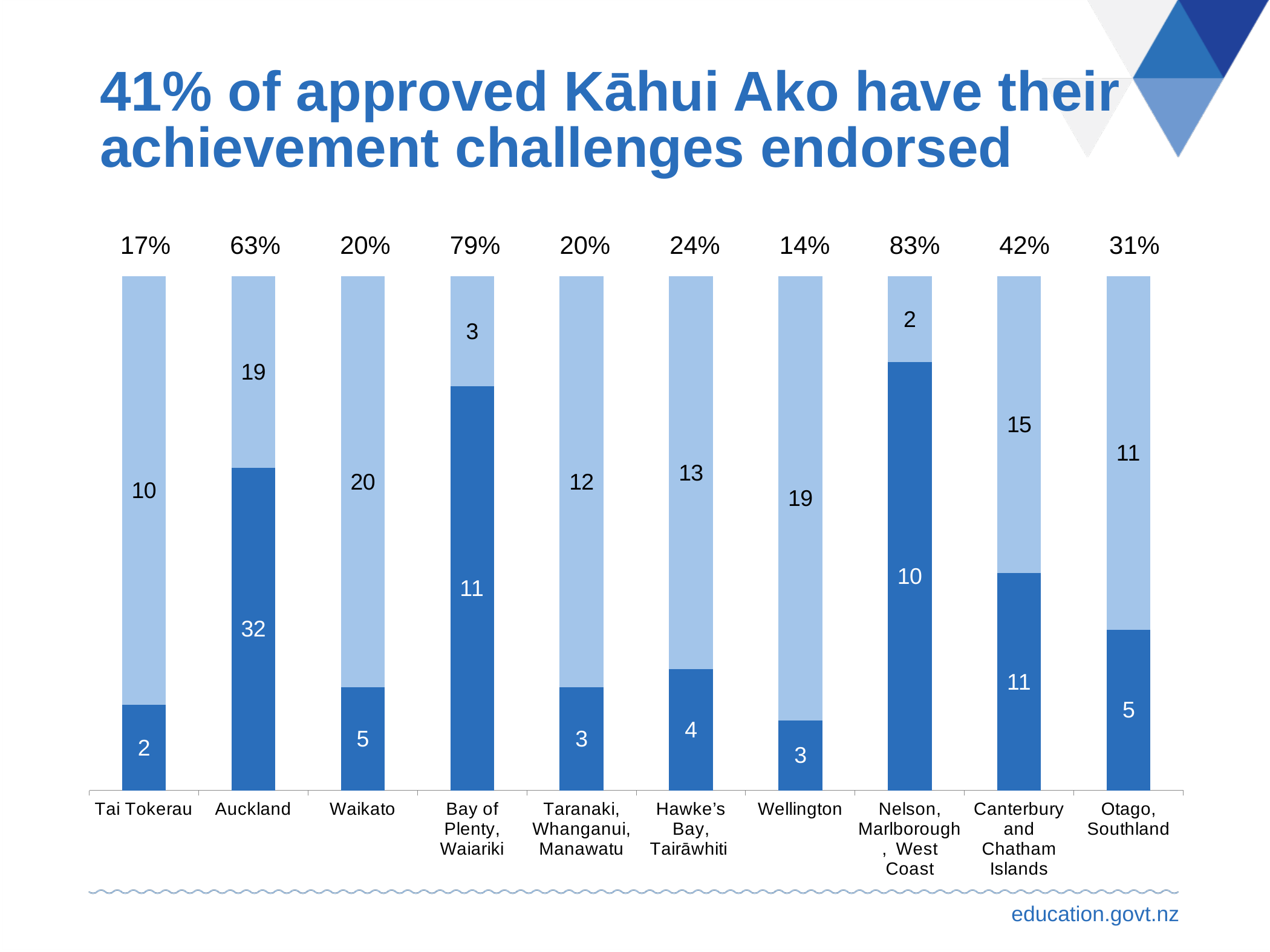
How many regions are shown on the x axis? 10 What is the difference between the dark blue values for Auckland and Canterbury and Chatham Islands? 21 What value is printed in the light blue segment of the Wellington bar? 19 Which has the larger dark blue value, Waikato or Otago, Southland? They are equal (5) What percentage is shown above the Auckland bar? 63% Which region has the lowest percentage shown above its bar? Wellington Which region has the highest percentage shown above its bar? Nelson, Marlborough, West Coast What is the title of the slide? 41% of approved Kāhui Ako have their achievement challenges endorsed What value is printed in the dark blue segment of the Bay of Plenty, Waiariki bar? 11 What is the total of the two segments in the Auckland bar? 51 Which has the larger light blue value, Hawke's Bay, Tairāwhiti or Taranaki, Whanganui, Manawatu? Hawke's Bay, Tairāwhiti What kind of chart is shown on the slide? Stacked bar chart